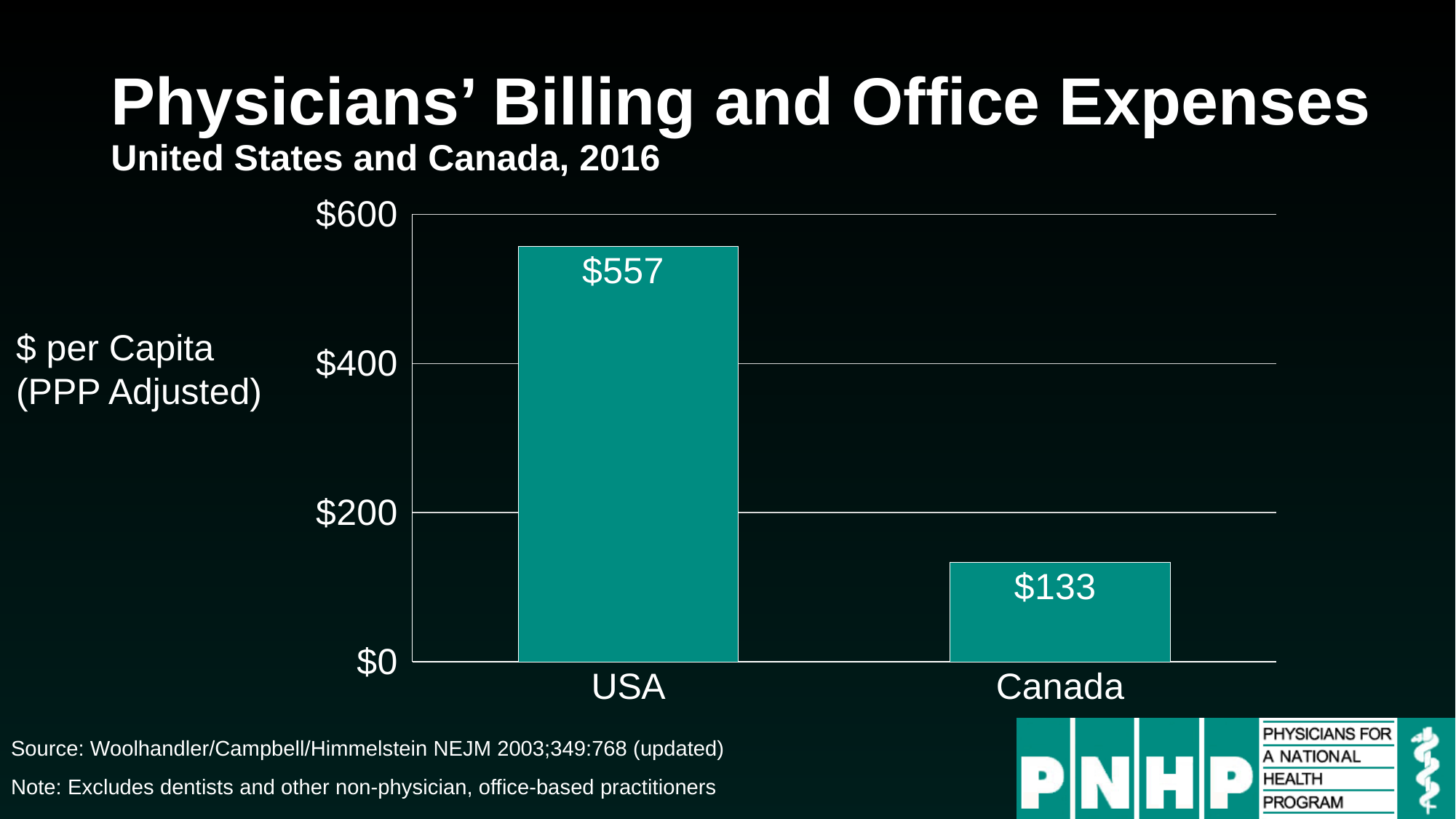
Which category has the lowest value? Canada What kind of chart is shown on the slide? bar chart What is the label on the vertical axis? $ per Capita (PPP Adjusted) What is the difference between the values for USA and Canada? $424 How many categories are shown in the chart? 2 Which is larger, the value for USA or the value for Canada? USA Is the value for USA greater or less than $400? greater Is the value for Canada greater or less than $200? less Which category has the highest value? USA What is the value for Canada? $133 What is the value for USA? $557 What is the title of the chart? Physicians' Billing and Office Expenses